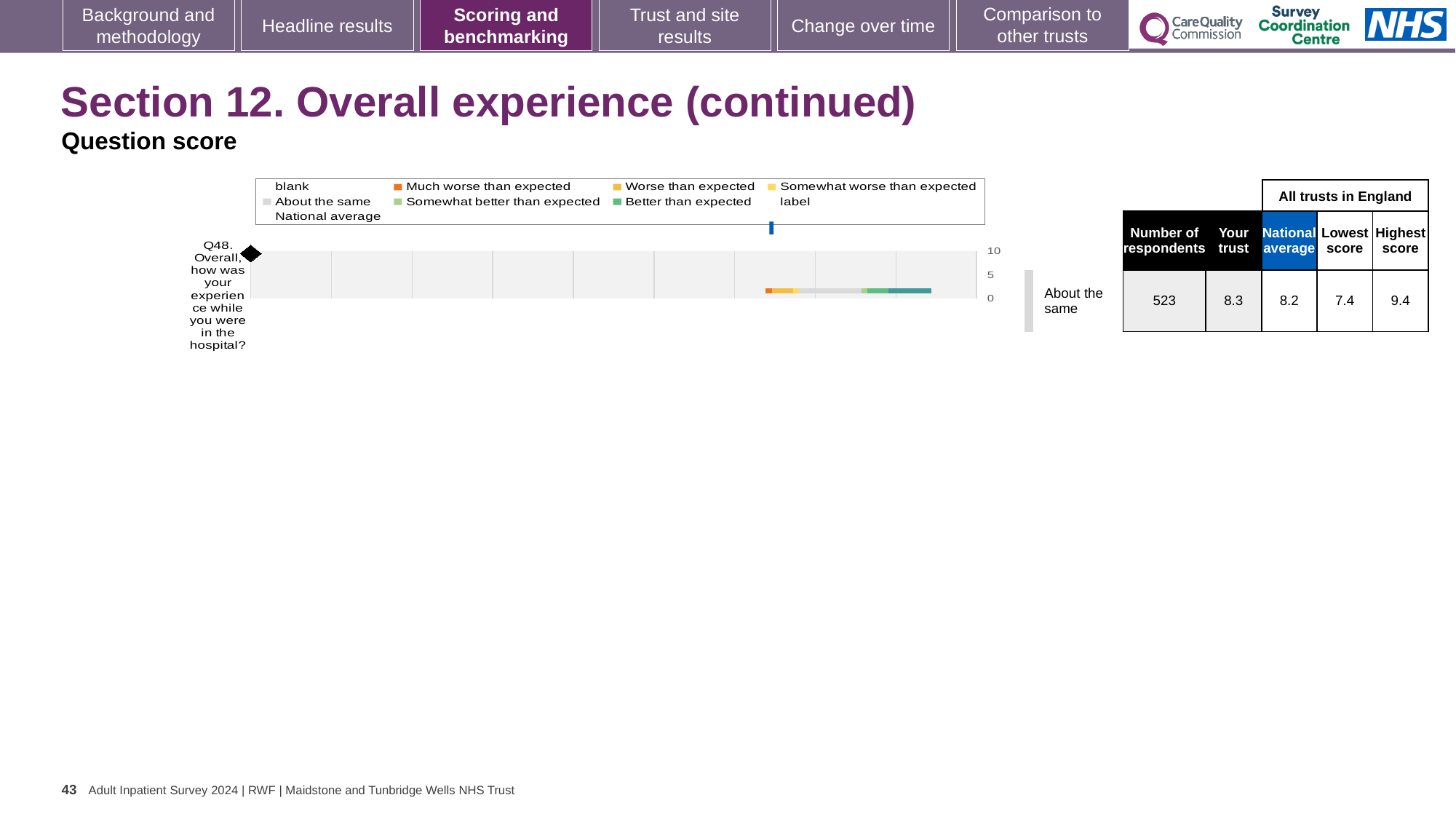
What is the highest score among all trusts in England for Q48? 9.4 What is the national average score for Q48? 8.2 Which is larger for Q48, the 'Your trust' score or the national average? Your trust How many survey questions are plotted in the chart? 1 What is the lowest score among all trusts in England for Q48? 7.4 Which question is plotted in the chart? Q48. Overall, how was your experience while you were in the hospital? What is the difference between the highest score and the lowest score for Q48? 2.0 What kind of chart is shown on the slide for Q48? bar chart What benchmark category is shown next to the bar for Q48? About the same What is the difference between the 'Your trust' score and the national average for Q48? 0.1 What is the 'Your trust' score for Q48? 8.3 What is the number of respondents for Q48? 523